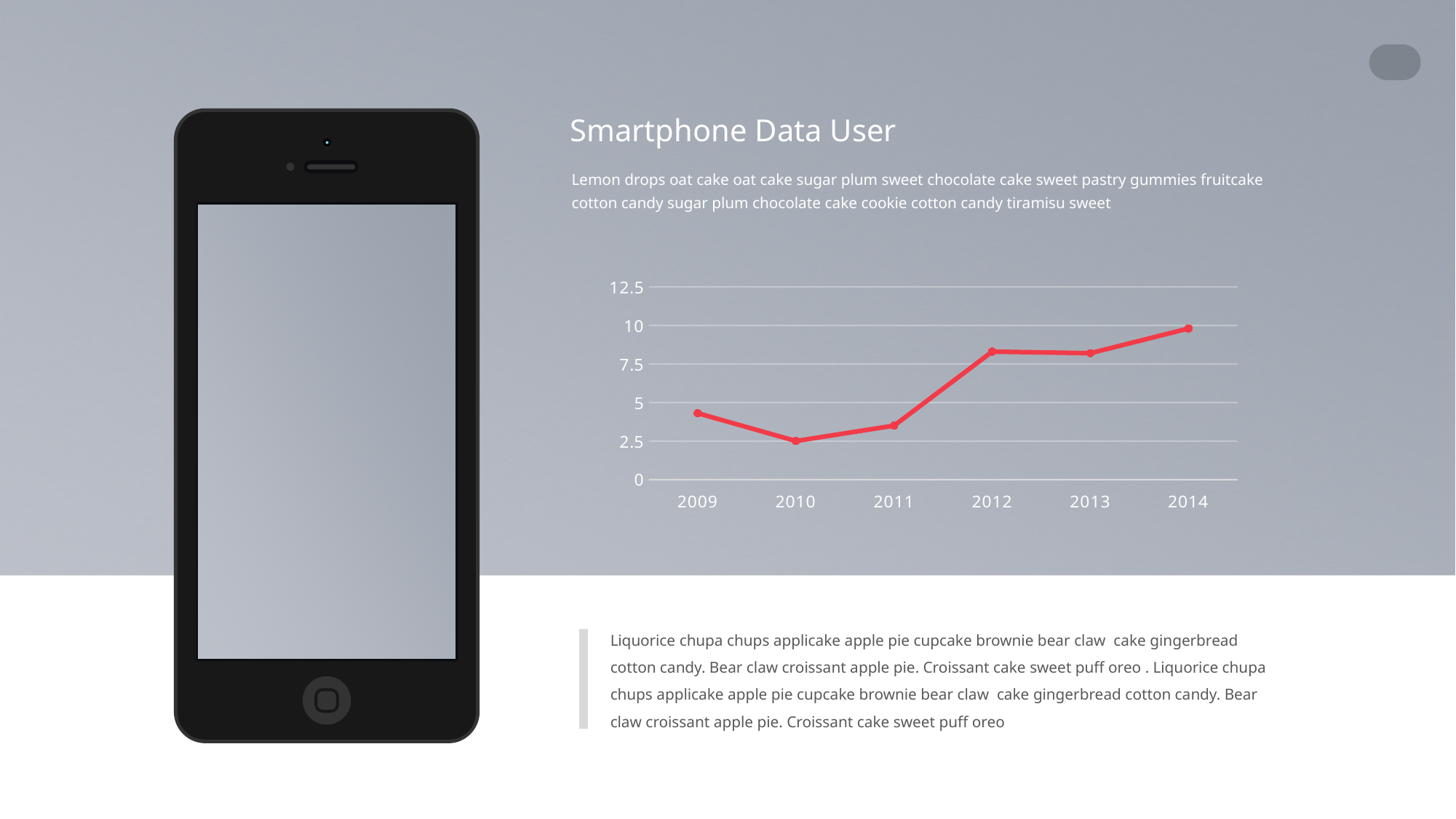
What colour is the line in the chart? red How many years are plotted along the x axis of the chart? 6 What kind of chart is shown on the slide? line chart Overall, do the values rise or fall from 2009 to 2014? rise Is the value for 2009 greater or less than 5? less Which is larger, the value for 2012 or the value for 2009? 2012 Is the value for 2014 greater or less than 7.5? greater Is the value for 2012 greater or less than 7.5? greater Which year has the lowest value in the chart? 2010 Which year has the highest value in the chart? 2014